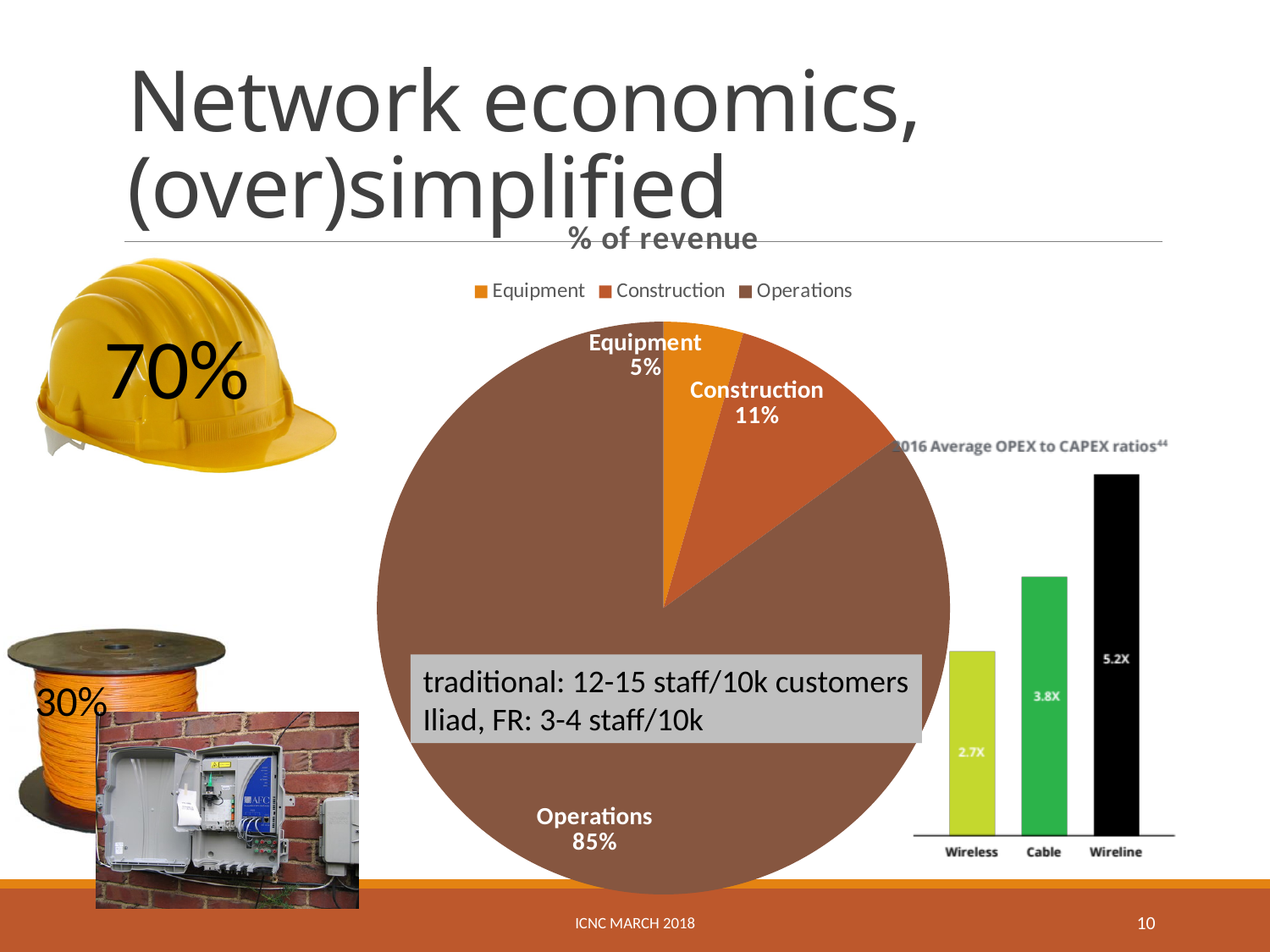
In the '% of revenue' pie chart, which slice is the smallest? Equipment In the '2016 Average OPEX to CAPEX ratios' chart, which category has the highest ratio? Wireline What kind of chart is the '2016 Average OPEX to CAPEX ratios' chart? Bar chart In the '2016 Average OPEX to CAPEX ratios' chart, what is the value for Cable? 3.8X In the '% of revenue' pie chart, what share does Equipment have? 5% What kind of chart is the '% of revenue' chart? Pie chart In the '% of revenue' pie chart, which slice is the largest? Operations In the '% of revenue' pie chart, what share does Construction have? 11% In the '% of revenue' pie chart, how many slices are there? 3 In the '% of revenue' pie chart, what is the difference between the Construction and Equipment shares? 6% In the '2016 Average OPEX to CAPEX ratios' chart, which category has the lowest ratio? Wireless In the '% of revenue' pie chart, what share does Operations have? 85%